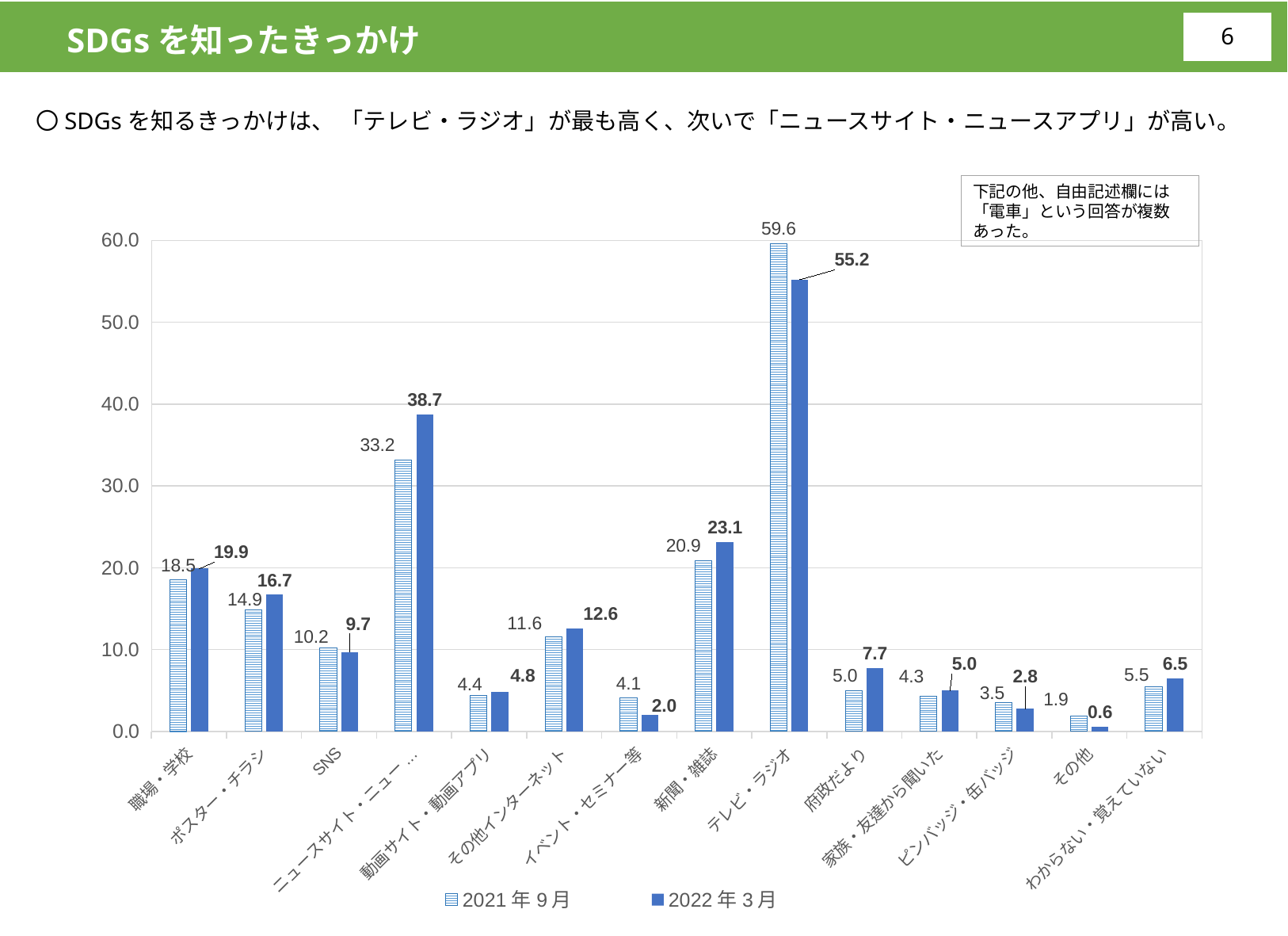
For SNS, which series has the larger value, 2021年9月 or 2022年3月? 2021年9月 Which category has the lowest value in the 2022年3月 series? その他 What is the value for 府政だより in the 2022年3月 series? 7.7 What kind of chart is shown on the slide? bar chart What is the difference between the 2022年3月 and 2021年9月 values for イベント・セミナー等? 2.1 How many categories are shown on the x axis? 14 What is the difference between the 2021年9月 and 2022年3月 values for テレビ・ラジオ? 4.4 Is the 2022年3月 value for 職場・学校 greater or less than 10.0? greater Which category has the highest value in the 2022年3月 series? テレビ・ラジオ What is the value for 新聞・雑誌 in the 2022年3月 series? 23.1 How many series does the legend list? 2 What is the value for テレビ・ラジオ in the 2021年9月 series? 59.6